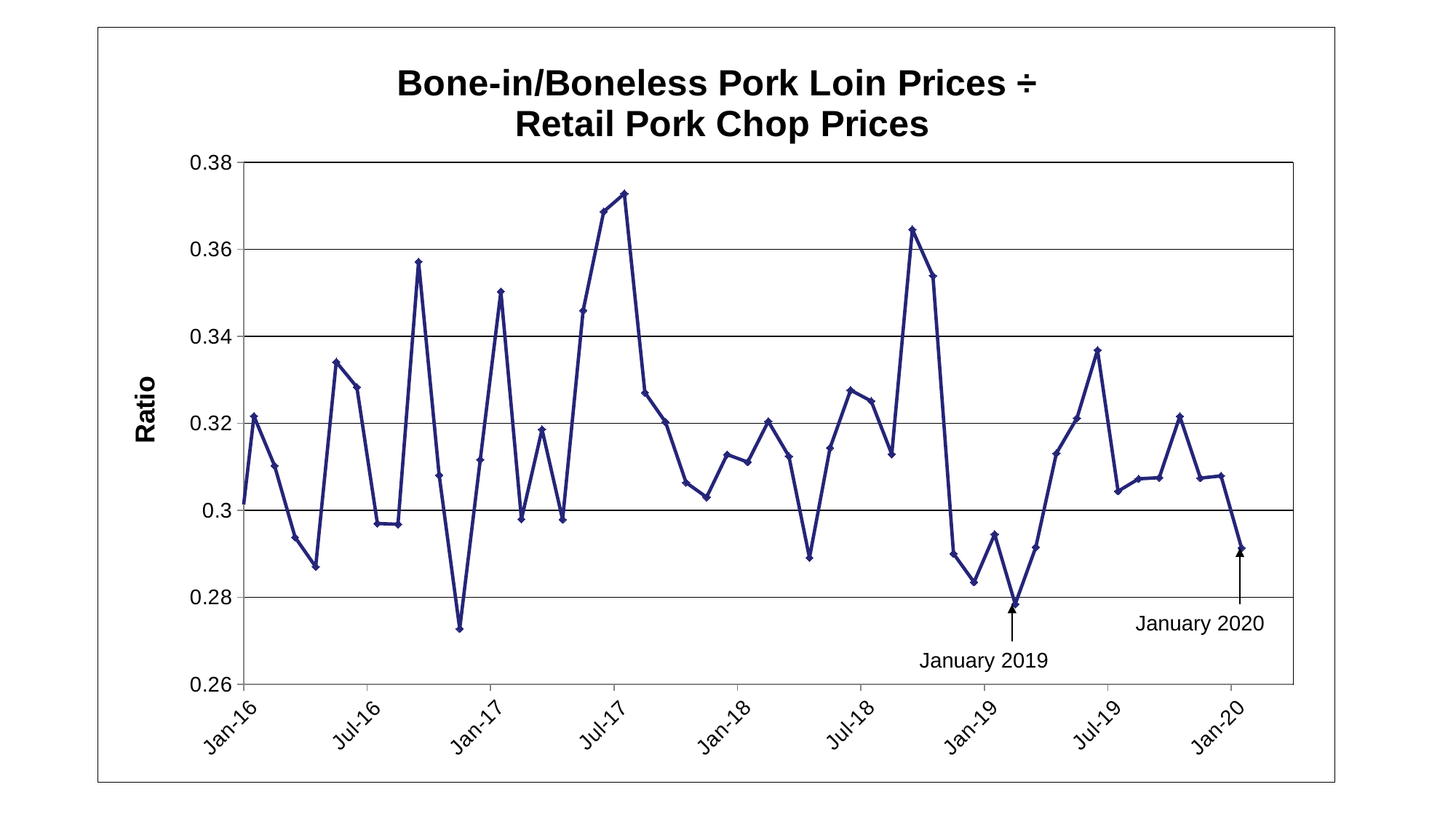
Is the value at Jul-17 greater or less than 0.36? greater What is the label on the vertical axis of the chart? Ratio Is the value at the point marked January 2020 greater or less than 0.28? greater What is the title of the chart? Bone-in/Boneless Pork Loin Prices ÷ Retail Pork Chop Prices Near which x-axis label does the line reach its highest value? Jul-17 Does the lowest point of the line occur before or after Jan-17? before Is the value at the point marked January 2019 greater or less than 0.30? less What kind of chart is shown on the slide? line chart How many date labels are shown along the x axis? 9